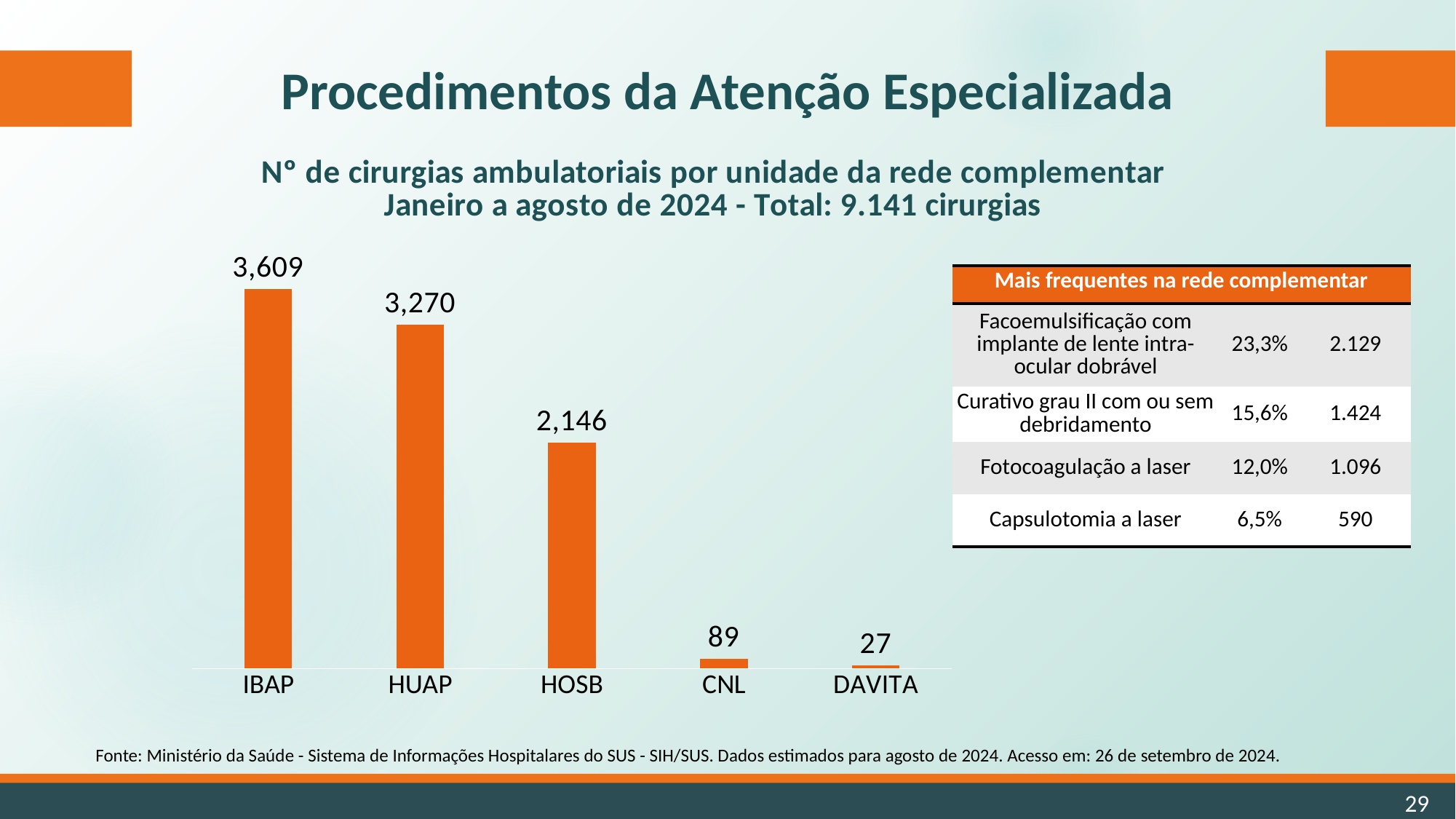
What is the value shown for CNL? 89 What is the number of ambulatory surgeries for IBAP? 3,609 What is the difference between the values for CNL and DAVITA? 62 Which has a larger value, HUAP or HOSB? HUAP What is the number of ambulatory surgeries for HOSB? 2,146 What is the value shown for DAVITA? 27 Which unit has the lowest number of ambulatory surgeries? DAVITA Do the values rise or fall from left to right across the units? Fall Which unit has the highest number of ambulatory surgeries? IBAP How many units are shown in the bar chart? 5 What is the difference between the values for IBAP and HUAP? 339 What kind of chart is used to show the number of surgeries per unit? Bar chart